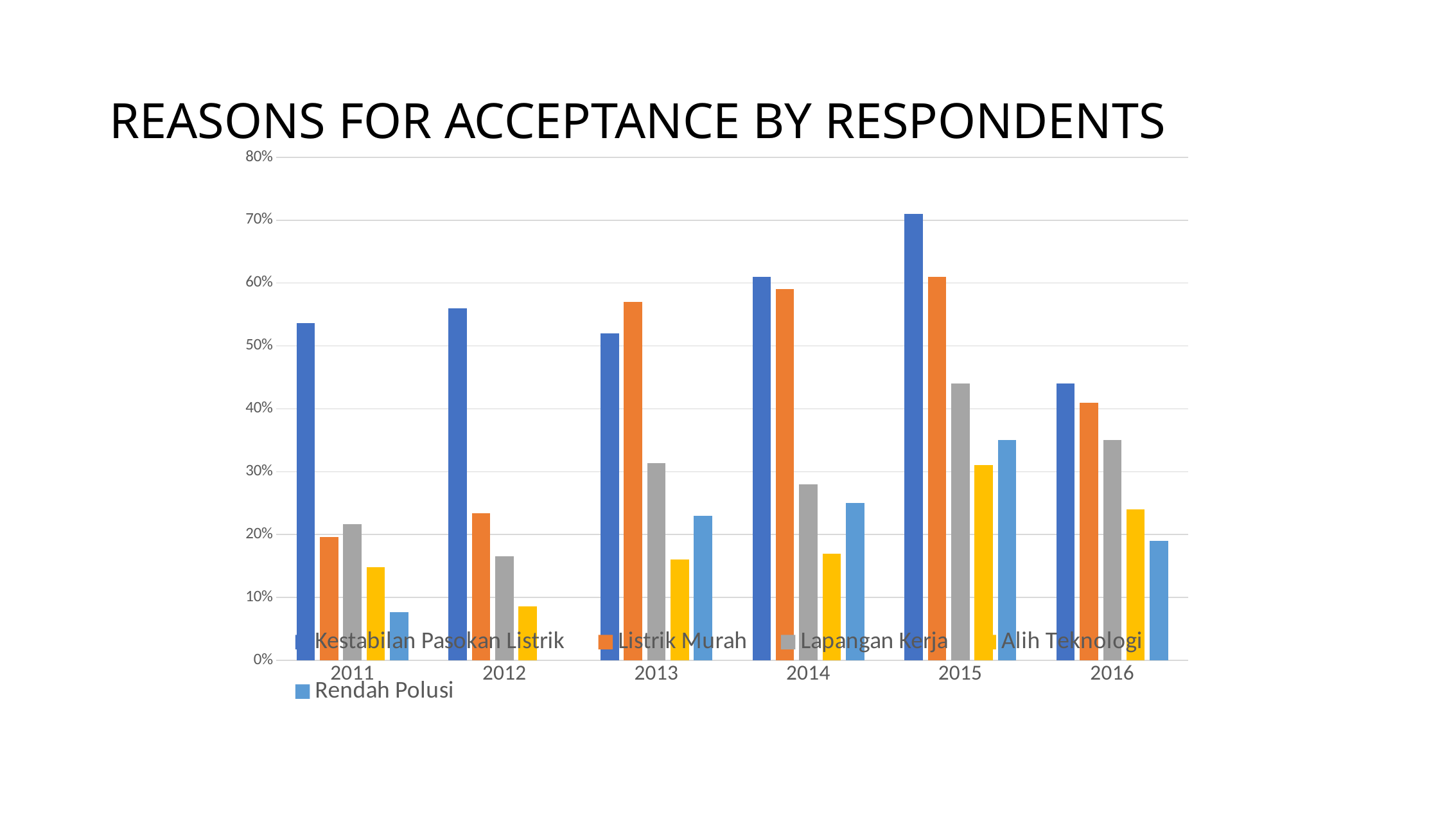
What is the title of the chart? REASONS FOR ACCEPTANCE BY RESPONDENTS Is the value for Kestabilan Pasokan Listrik in 2015 greater or less than 60%? greater Which series is shown in orange? Listrik Murah Which is larger in 2013, Kestabilan Pasokan Listrik or Listrik Murah? Listrik Murah Is the value for Lapangan Kerja in 2015 greater or less than 40%? greater In which year is the value for Kestabilan Pasokan Listrik lowest? 2016 How many years are shown on the x axis? 6 In which year is the value for Kestabilan Pasokan Listrik highest? 2015 Is the value for Alih Teknologi in 2012 greater or less than 10%? less What kind of chart is shown on the slide? bar chart Does the value for Listrik Murah rise or fall from 2013 to 2015? rise How many series does the legend list? 5